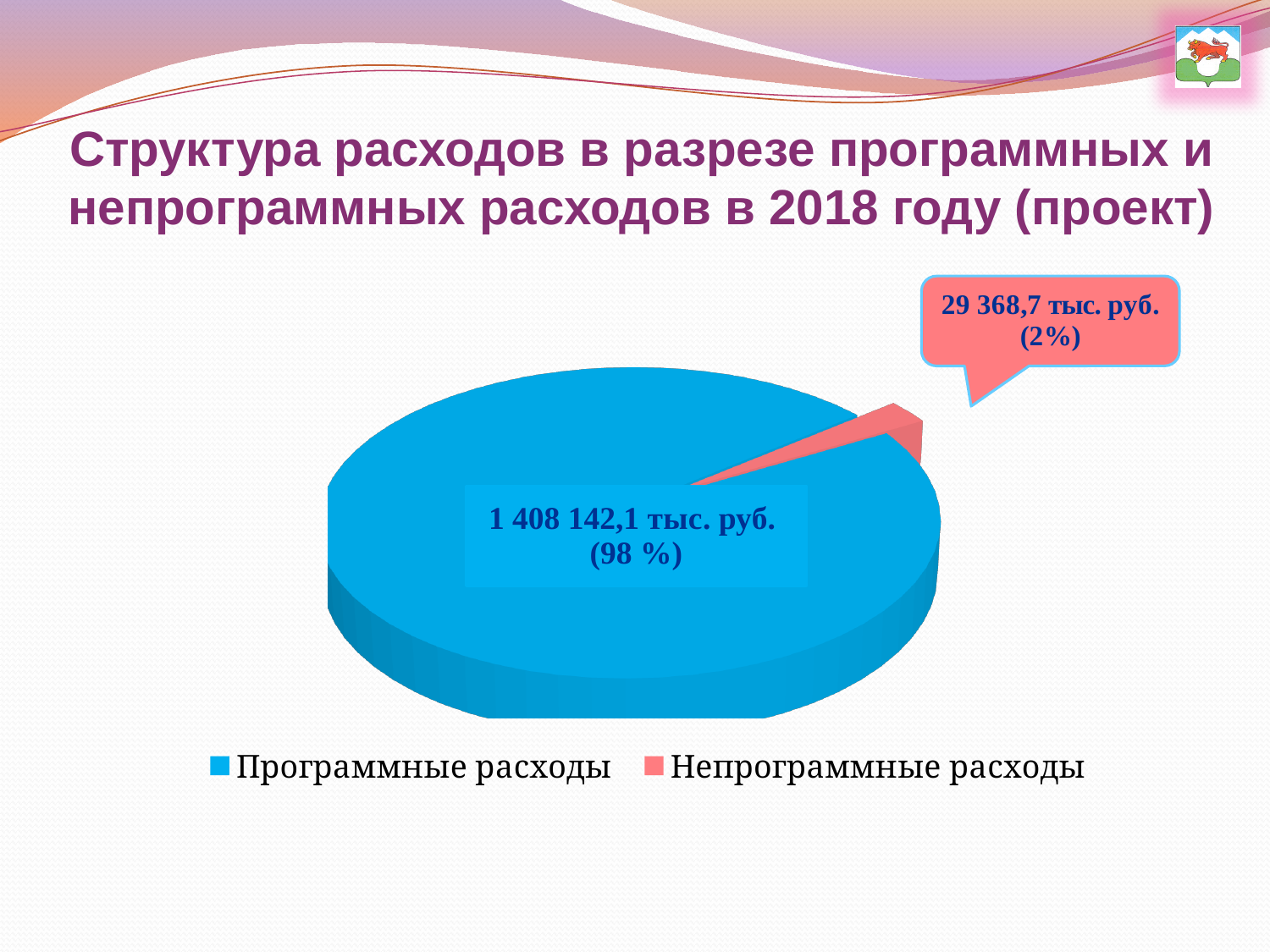
What is the value for Непрограммные расходы? 29 368,7 тыс. руб. Which category has the smallest slice? Непрограммные расходы Which is larger, Программные расходы or Непрограммные расходы? Программные расходы How many categories does the pie chart have? 2 What share of the pie does Программные расходы take? 98 % What kind of chart is shown on the slide? pie chart How many entries does the legend list? 2 What share of the pie does Непрограммные расходы take? 2% What is the value for Программные расходы? 1 408 142,1 тыс. руб. What is the title of the slide? Структура расходов в разрезе программных и непрограммных расходов в 2018 году (проект) Which category has the largest slice? Программные расходы What colour is the slice for Непрограммные расходы? red (pink)